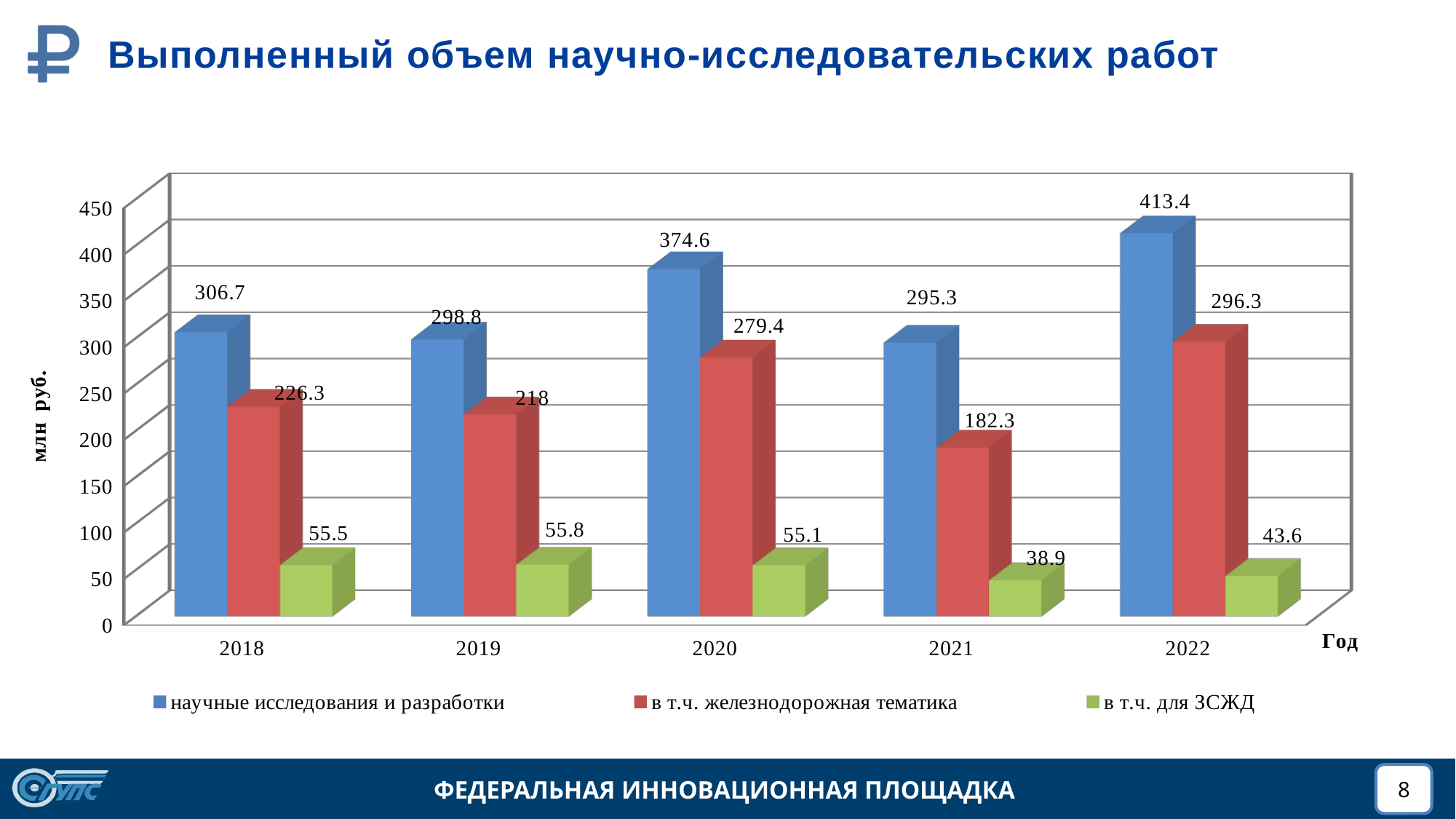
Is the value for "научные исследования и разработки" in 2021 greater or less than 300? less What unit is shown on the y axis label? млн руб. Which is larger: the "в т.ч. железнодорожная тематика" value in 2018 or in 2019? 2018 What is the value for "в т.ч. для ЗСЖД" in 2019? 55.8 What is the value for "в т.ч. железнодорожная тематика" in 2021? 182.3 In which year is the value for "научные исследования и разработки" the highest? 2022 What is the difference between the "научные исследования и разработки" value and the "в т.ч. железнодорожная тематика" value in 2022? 117.1 How many series does the legend list? 3 What kind of chart is shown on the slide? bar chart In which year is the value for "в т.ч. для ЗСЖД" the lowest? 2021 What is the value for "научные исследования и разработки" in 2020? 374.6 How many years are shown on the x axis? 5